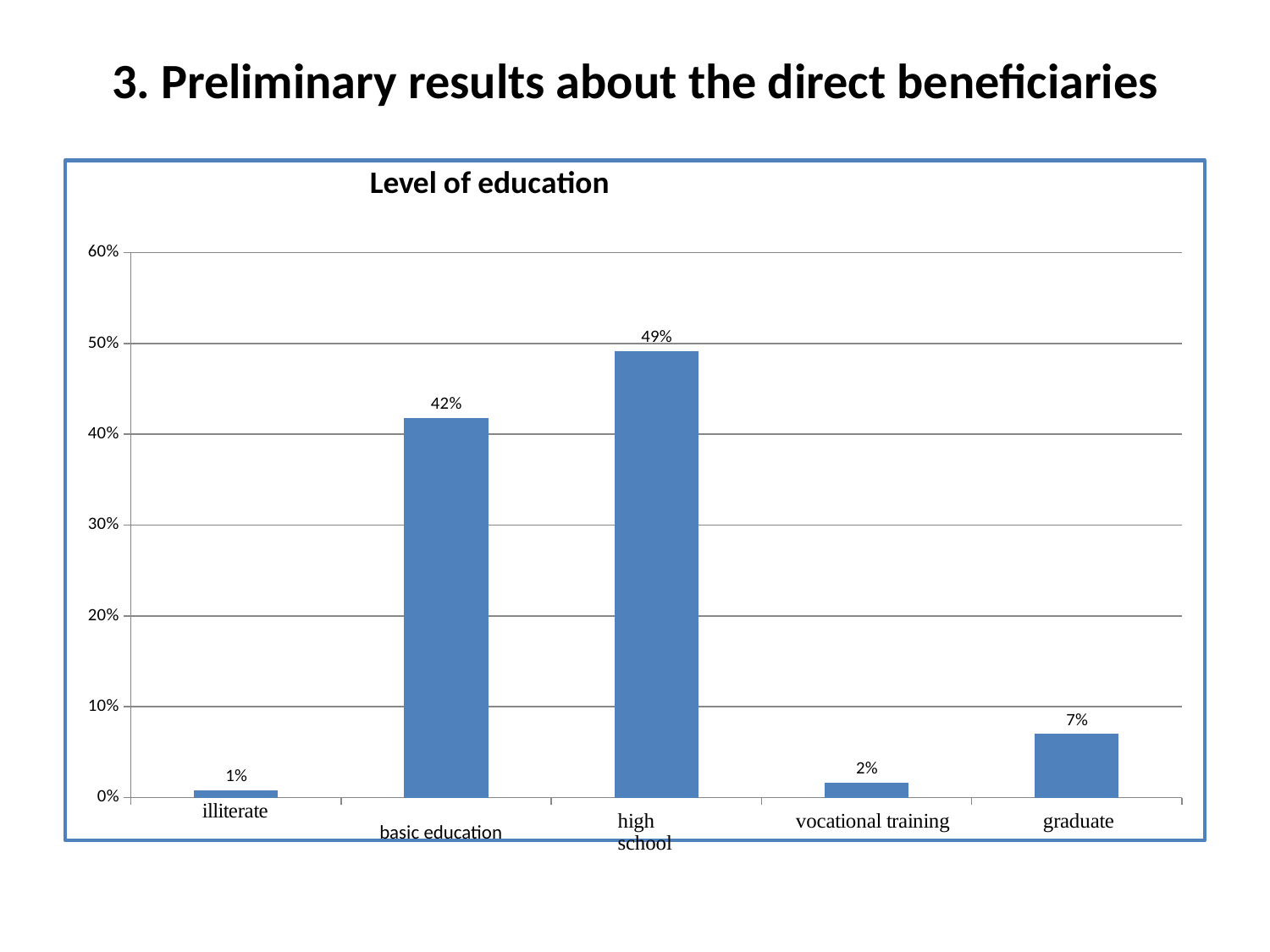
What is the value for high school? 49% Which level of education has the lowest value? illiterate What is the difference between the values for graduate and vocational training? 5% Which level of education has the highest value? high school Which is larger, the value for graduate or the value for vocational training? graduate What is the difference between the values for high school and basic education? 7% What kind of chart is shown on the slide? bar chart How many categories are shown on the x axis? 5 Is the value for basic education greater or less than 40%? greater What is the value for graduate? 7% What is the value for basic education? 42% What is the value for vocational training? 2%